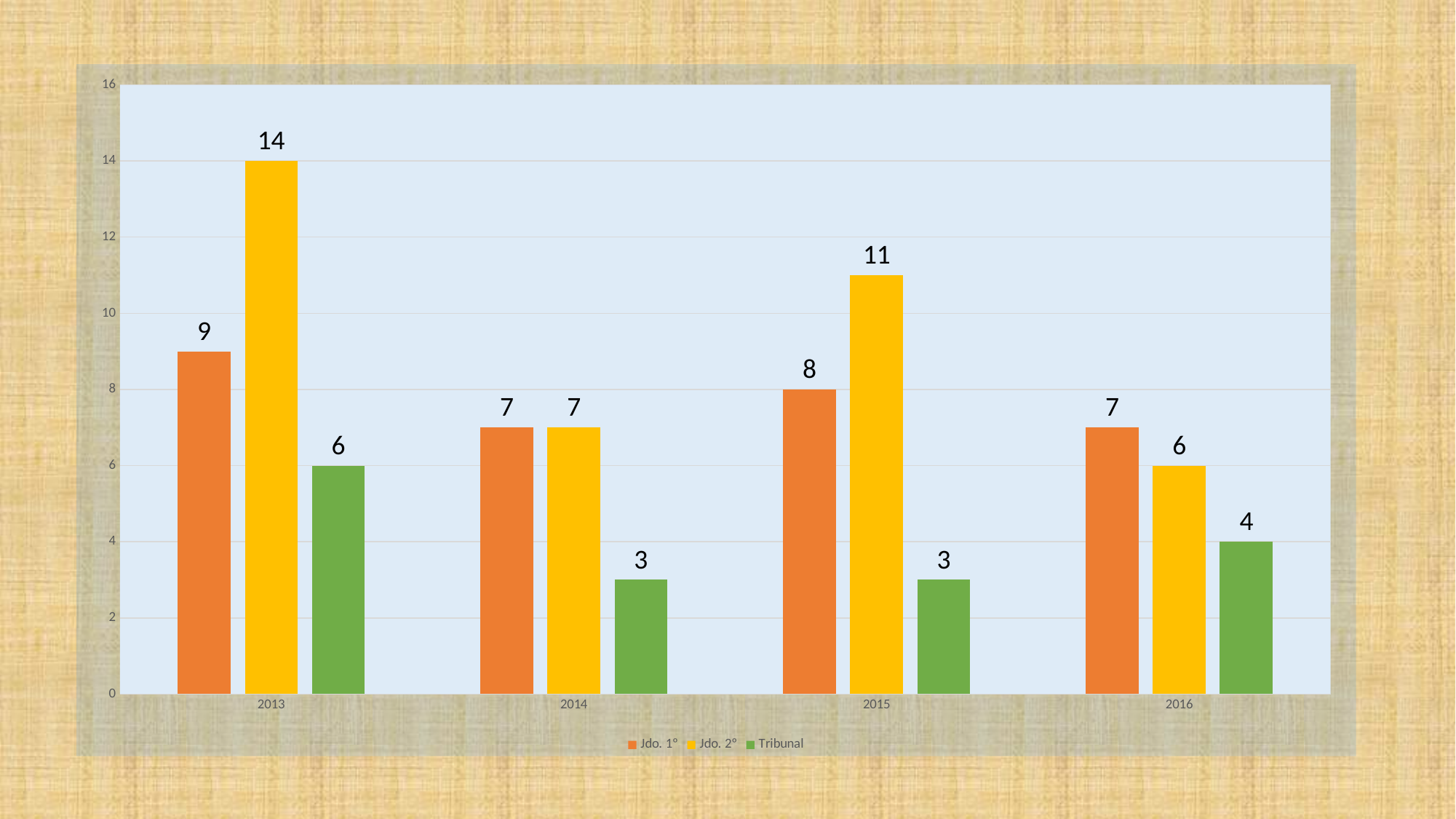
In which year is the Jdo. 1° value lowest? 2014 and 2016 Which is larger in 2016, Jdo. 1° or Jdo. 2°? Jdo. 1° Which colour represents the Tribunal series? Green What kind of chart is shown? Bar chart How many series does the legend list? 3 What is the value for Tribunal in 2016? 4 How many years are shown on the x axis? 4 In which year is the Jdo. 2° value highest? 2013 Does the Tribunal value rise or fall from 2013 to 2014? Fall What is the value for Jdo. 1° in 2015? 8 What is the difference between Jdo. 2° and Tribunal in 2015? 8 What is the value for Jdo. 2° in 2013? 14